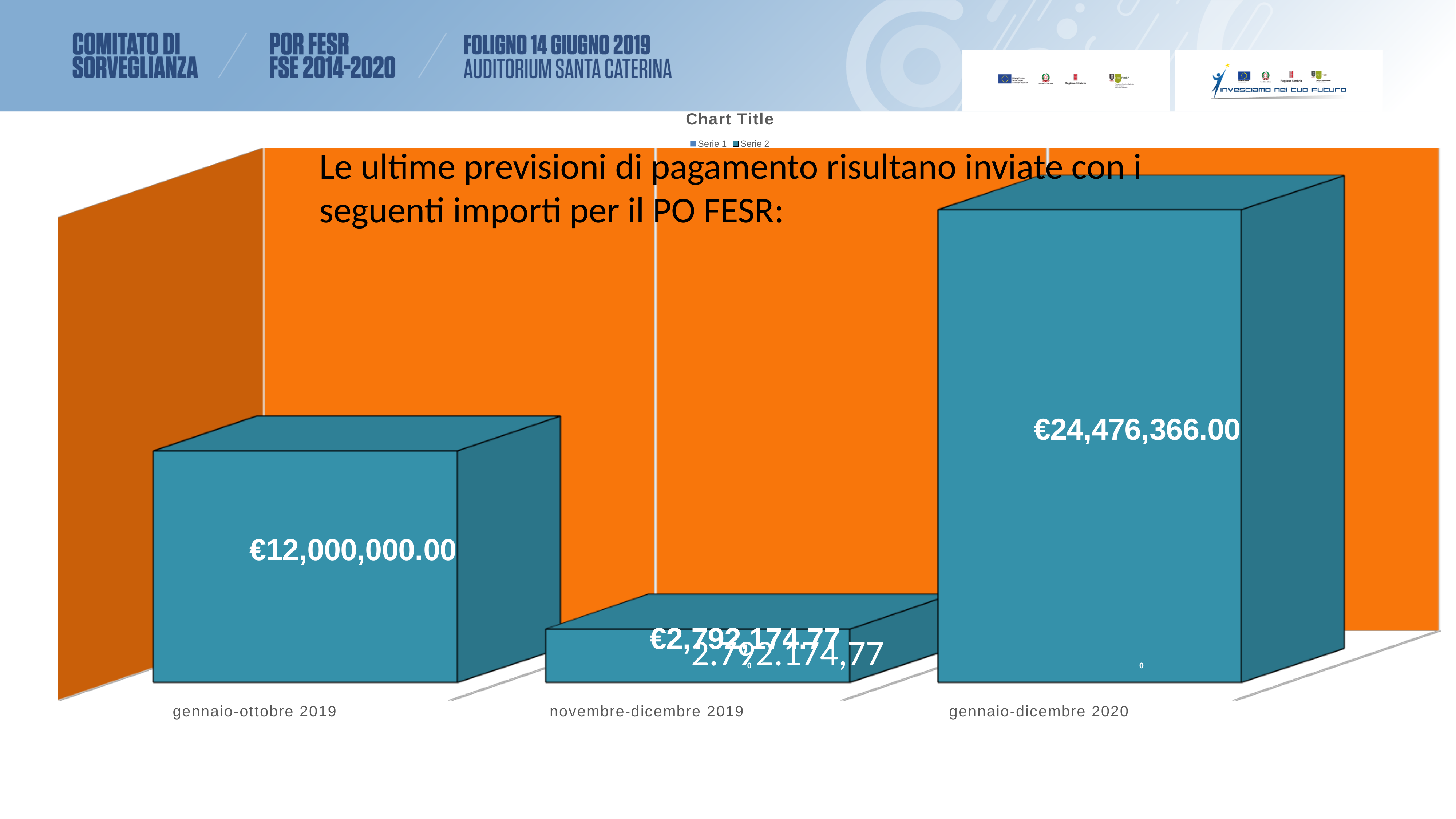
Which is larger, the value for gennaio-ottobre 2019 or the value for novembre-dicembre 2019? gennaio-ottobre 2019 Which category has the lowest value? novembre-dicembre 2019 Does the value rise or fall from novembre-dicembre 2019 to gennaio-dicembre 2020? rise What is the value for novembre-dicembre 2019? €2,792,174.77 What kind of chart is shown on the slide? bar chart How many categories are shown on the x axis? 3 What is the difference between the values for gennaio-ottobre 2019 and novembre-dicembre 2019? €9,207,825.23 What is the value for gennaio-ottobre 2019? €12,000,000.00 Which category has the highest value? gennaio-dicembre 2020 How many series does the legend list? 2 What is the difference between the values for gennaio-dicembre 2020 and gennaio-ottobre 2019? €12,476,366.00 What is the value for gennaio-dicembre 2020? €24,476,366.00